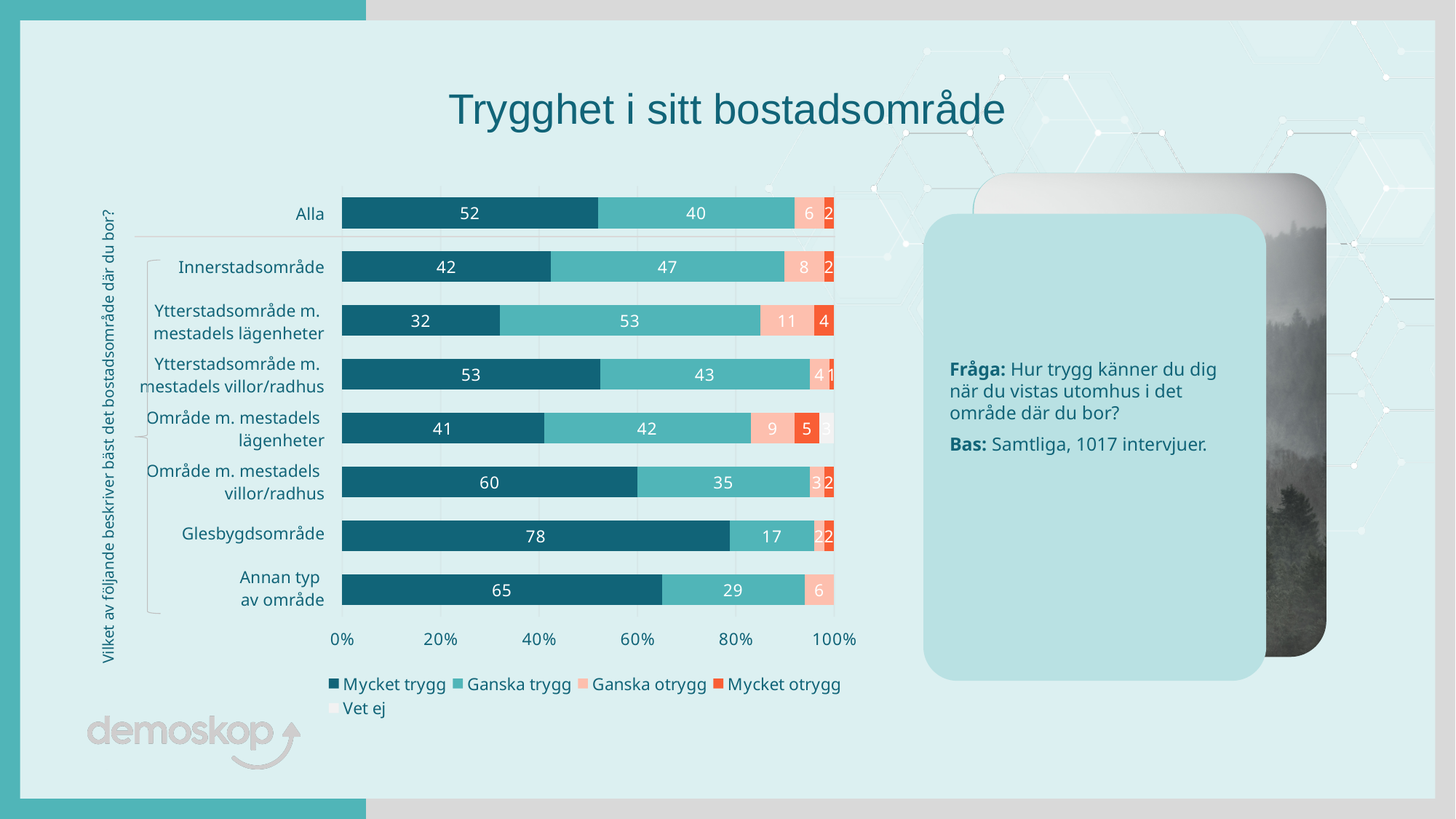
What is the value of "Ganska trygg" for Innerstadsområde? 47 What is the difference between the "Mycket trygg" values for Glesbygdsområde and Alla? 26 What is the value of "Ganska otrygg" for Ytterstadsområde m. mestadels lägenheter? 11 Which category has the highest value for "Mycket trygg"? Glesbygdsområde What is the value of "Mycket trygg" for Glesbygdsområde? 78 What is the value of "Mycket otrygg" for Område m. mestadels lägenheter? 5 What is the title of the chart? Trygghet i sitt bostadsområde Which category has the lowest value for "Mycket trygg"? Ytterstadsområde m. mestadels lägenheter What kind of chart is shown on the slide? Stacked bar chart How many series does the legend list? 5 Which has a larger "Ganska trygg" value: Ytterstadsområde m. mestadels lägenheter or Annan typ av område? Ytterstadsområde m. mestadels lägenheter How many categories are plotted on the chart? 8